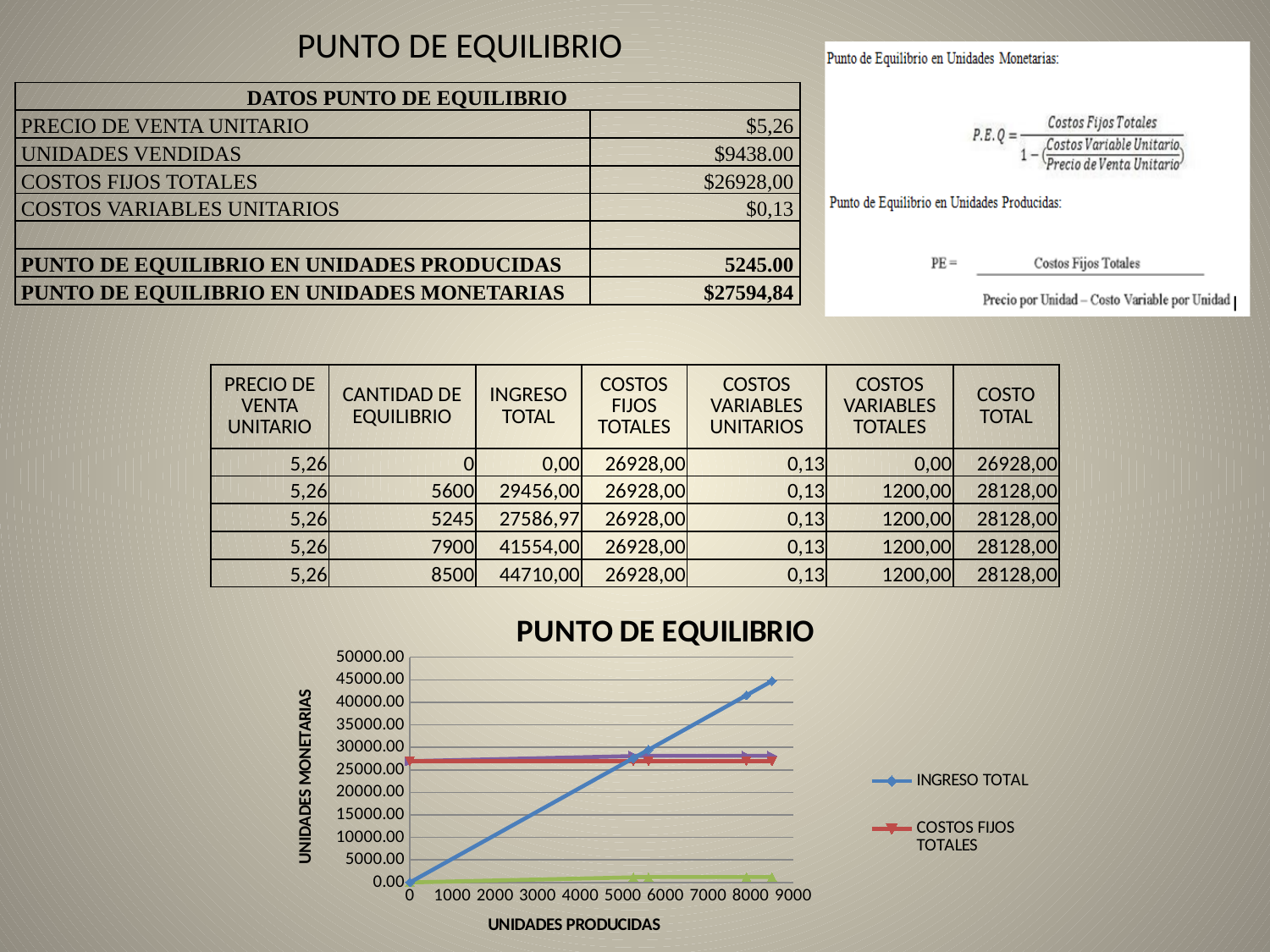
Does the INGRESO TOTAL line rise or fall as UNIDADES PRODUCIDAS increases? rise What is the title of the chart? PUNTO DE EQUILIBRIO What is the label of the y axis of the chart? UNIDADES MONETARIAS At 8500 units produced, which is larger: INGRESO TOTAL or COSTOS FIJOS TOTALES? INGRESO TOTAL Is the value of INGRESO TOTAL at 8500 units greater or less than 40000.00? greater Is the value of COSTOS FIJOS TOTALES at 8500 units greater or less than 25000.00? greater At 0 units produced, which is larger: INGRESO TOTAL or COSTOS FIJOS TOTALES? COSTOS FIJOS TOTALES Does the COSTOS FIJOS TOTALES line rise, fall, or stay flat as UNIDADES PRODUCIDAS increases? stay flat How many series does the chart legend list? 2 Is the value of COSTOS FIJOS TOTALES at 0 units greater or less than 30000.00? less What kind of chart is shown on the slide? line chart